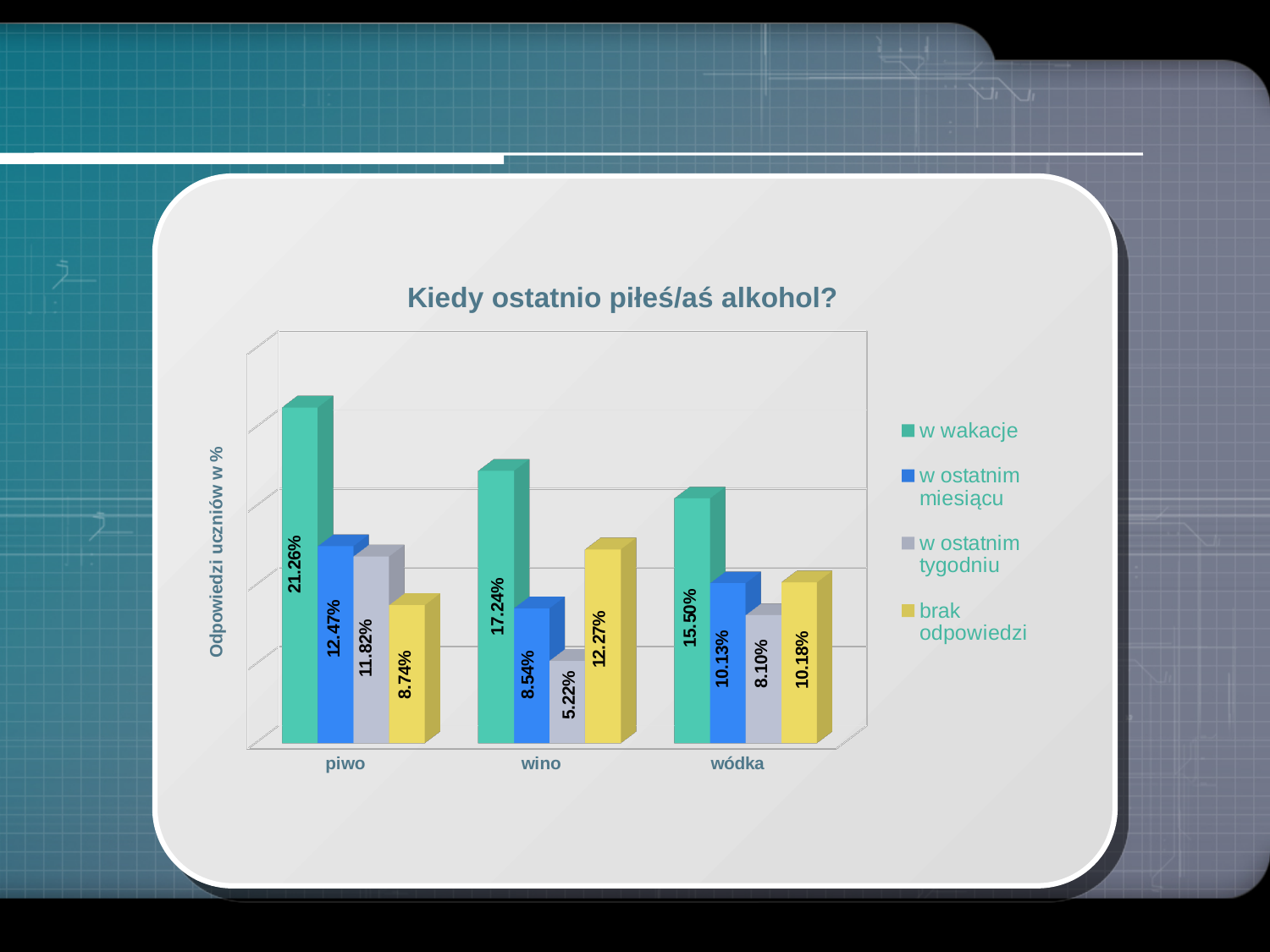
What is the difference between the 'w wakacje' values for 'piwo' and 'wino'? 4.02% What is the value for 'w ostatnim tygodniu' in the 'wino' category? 5.22% What is the title of the chart? Kiedy ostatnio piłeś/aś alkohol? How many categories are shown on the x axis? 3 Which category has the highest value for the 'w wakacje' series? piwo Which is larger: 'w ostatnim miesiącu' for 'wino' or 'brak odpowiedzi' for 'wino'? brak odpowiedzi for wino How many series does the legend list? 4 What is the value for 'w wakacje' in the 'piwo' category? 21.26% What is the value for 'brak odpowiedzi' in the 'wódka' category? 10.18% Which category has the lowest value for the 'w ostatnim tygodniu' series? wino What is the difference between the 'brak odpowiedzi' values for 'wino' and 'piwo'? 3.53% What is the value for 'w ostatnim miesiącu' in the 'wódka' category? 10.13%